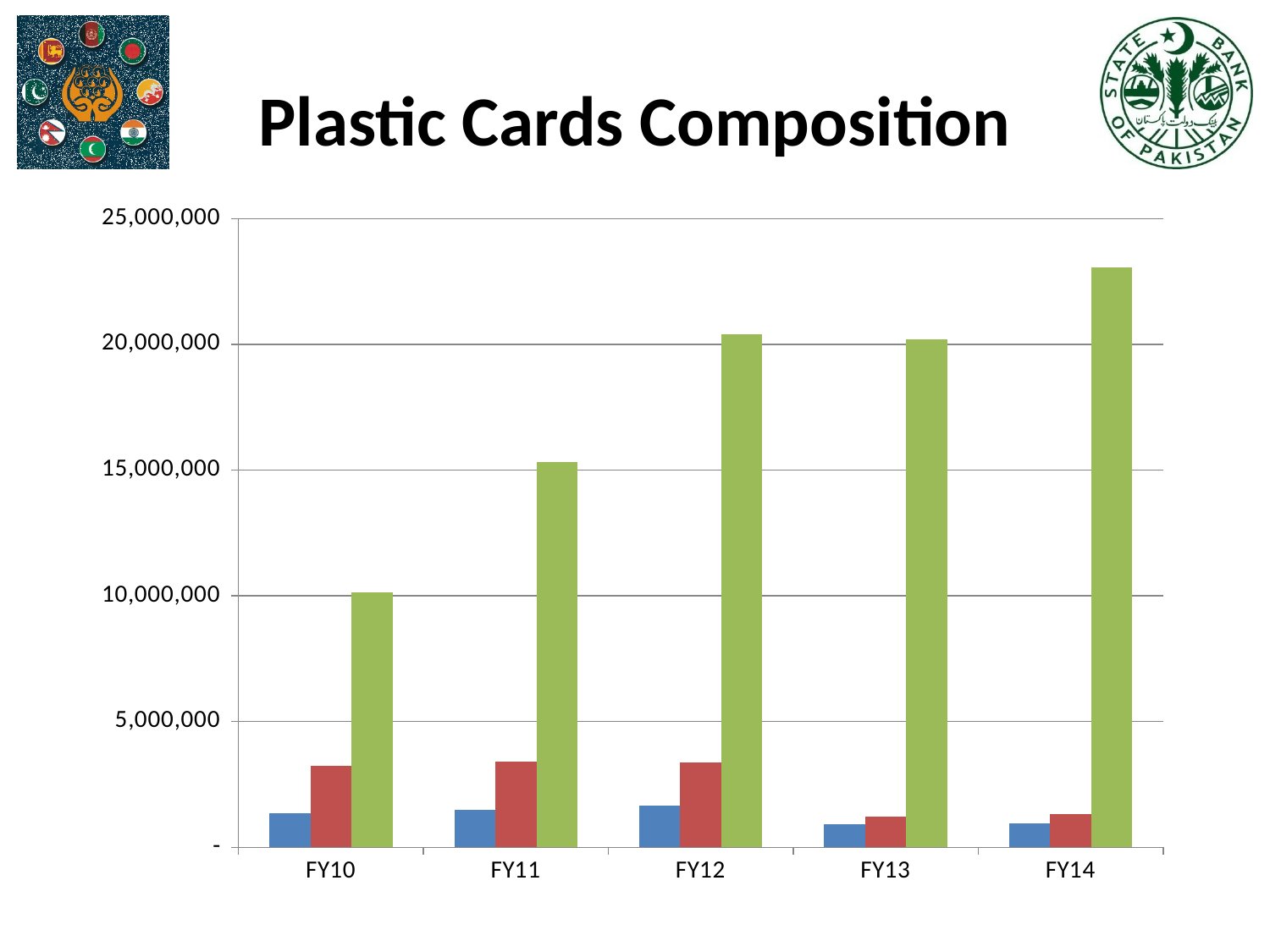
Is the green bar for FY10 greater or less than 15,000,000? less How many bars are plotted for each fiscal year in the chart? 3 How many fiscal years are shown on the x axis of the chart? 5 Is the green bar for FY14 greater or less than 20,000,000? greater In which fiscal year is the green bar the shortest? FY10 In which fiscal year is the green bar the tallest? FY14 What type of chart is shown on the slide? Bar chart Is the red bar for FY11 greater or less than 5,000,000? less Which is larger, the red bar for FY11 or the red bar for FY13? FY11 What is the title of the chart? Plastic Cards Composition Which is larger, the blue bar for FY12 or the blue bar for FY13? FY12 Do the green bars generally rise or fall from FY10 to FY14? rise